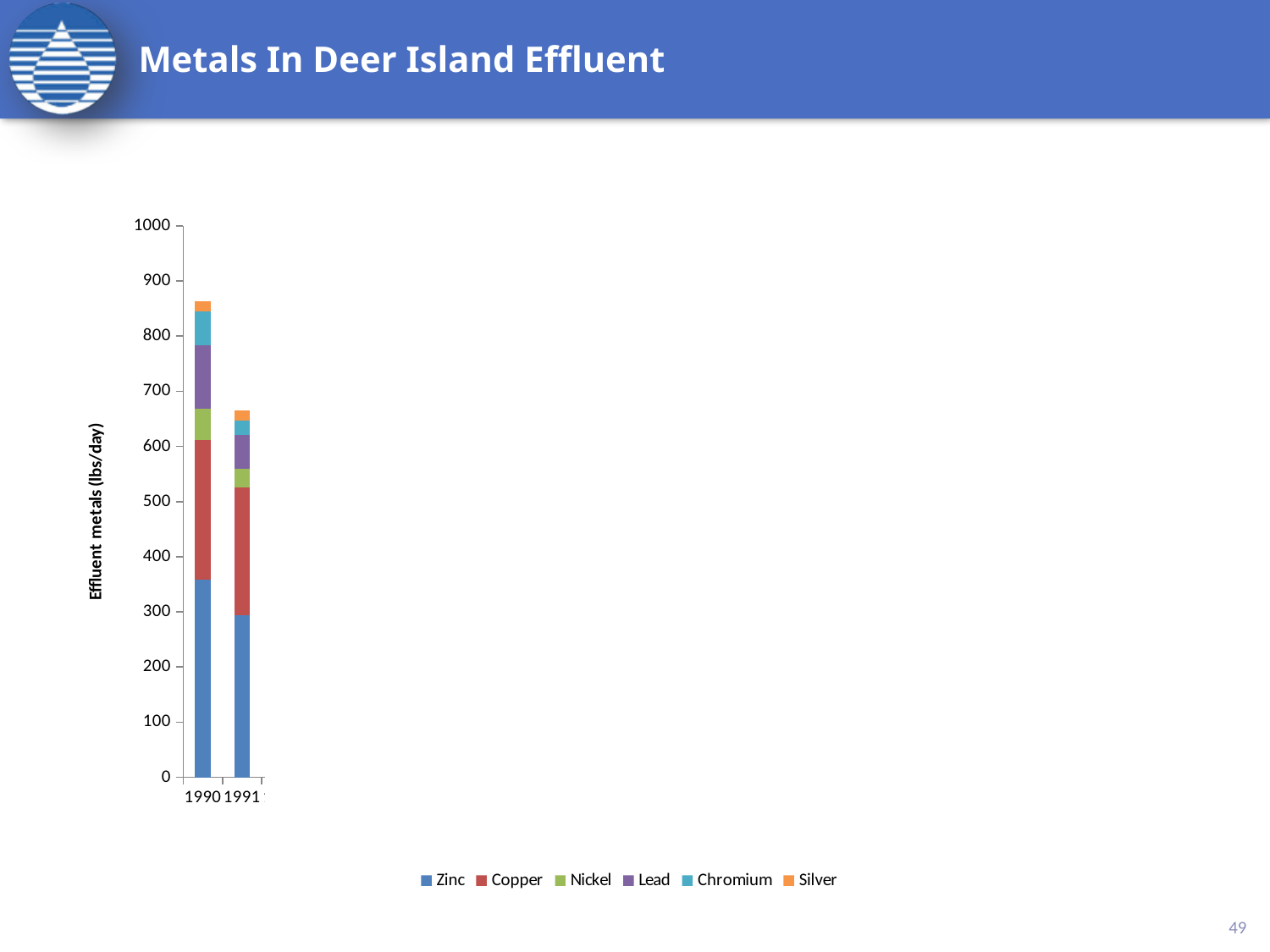
Which year has the larger Zinc segment, 1990 or 1991? 1990 What is the label on the vertical axis? Effluent metals (lbs/day) Which series is listed first in the legend? Zinc Which year has the taller stacked bar, 1990 or 1991? 1990 Is the total stacked value for 1990 greater or less than 800? greater Do the total effluent metals rise or fall from 1990 to 1991? fall Is the Zinc value for 1991 greater or less than 400? less What kind of chart is shown on the slide? stacked bar chart Is the total stacked value for 1991 greater or less than 700? less How many series does the legend list? 6